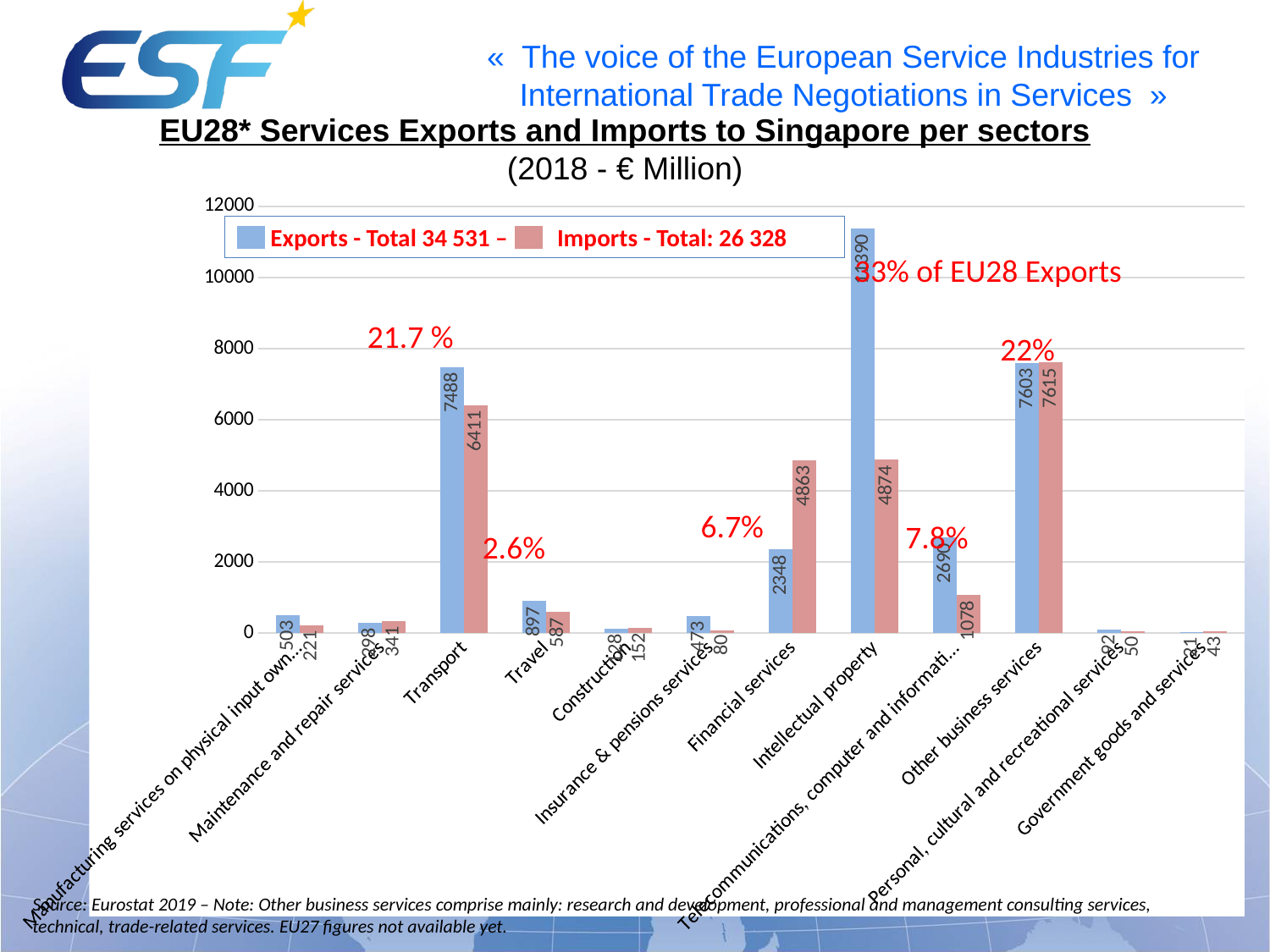
What kind of chart is shown on the slide? bar chart How many sector categories are plotted along the x axis? 12 Which sector has the highest Exports value? Intellectual property For Financial services, which is larger, Exports or Imports? Imports What is the value of Exports for Transport? 7488 What is the difference between Exports and Imports for Transport? 1077 What is the value of Imports for Financial services? 4863 According to the legend, what is the total of Exports? 34 531 Is the Exports value for Intellectual property greater or less than 10000? greater How many series does the legend list? 2 What is the value of Imports for Transport? 6411 What is the value of Exports for Other business services? 7603